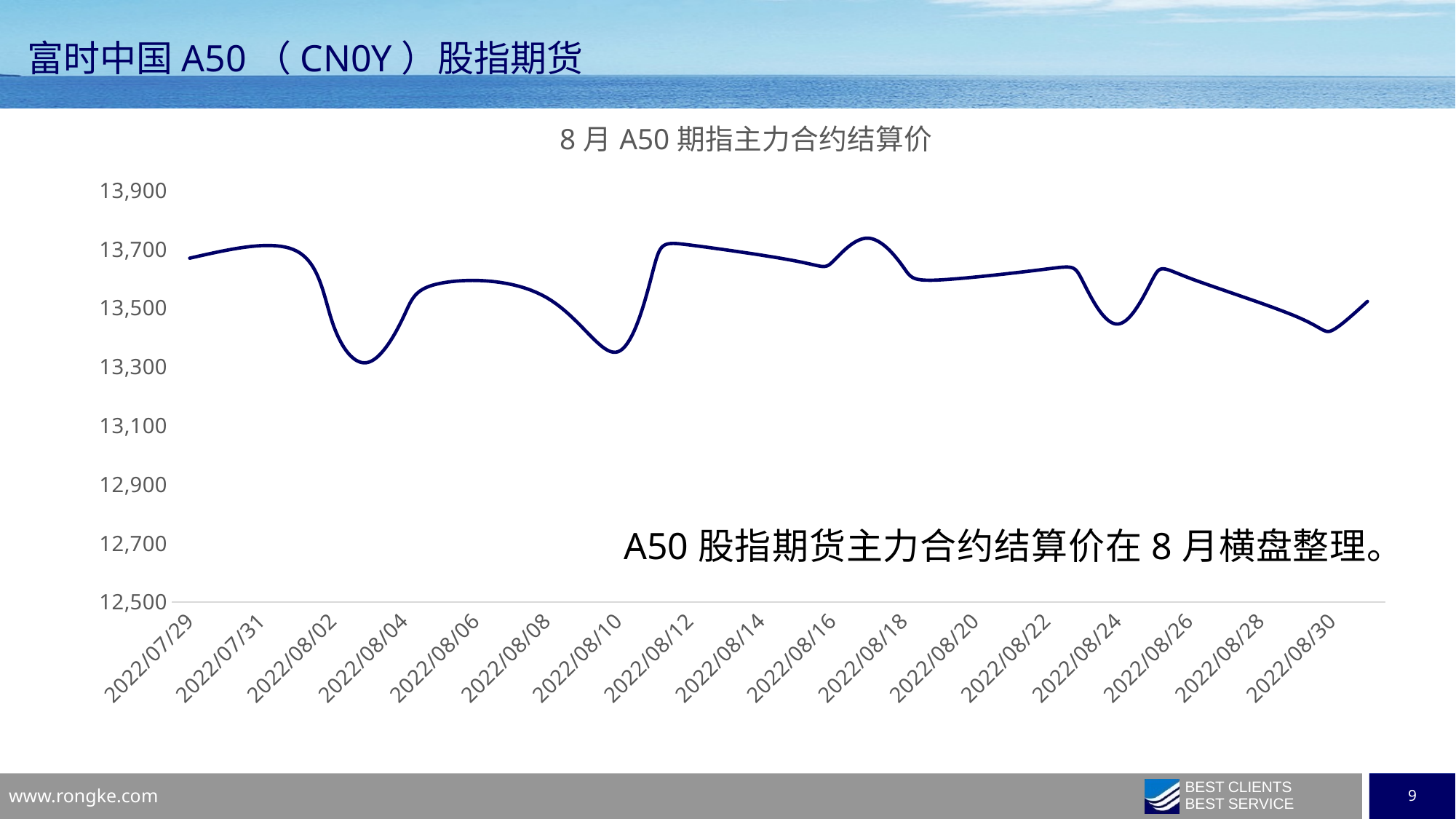
Is the value for 2022/08/12 greater or less than 13,500? greater Is the value for 2022/07/29 greater or less than 13,500? greater Comparing the first date (2022/07/29) with the last date (2022/08/30), does the line end higher or lower than it started? lower Is the value for 2022/08/24 greater or less than 13,700? less How many date labels are shown on the x axis of the chart? 17 What is the highest value shown on the y axis of the chart? 13,900 How many lines are plotted on the chart? 1 What kind of chart is shown on the slide? line chart What is the title of the chart? 8月A50期指主力合约结算价